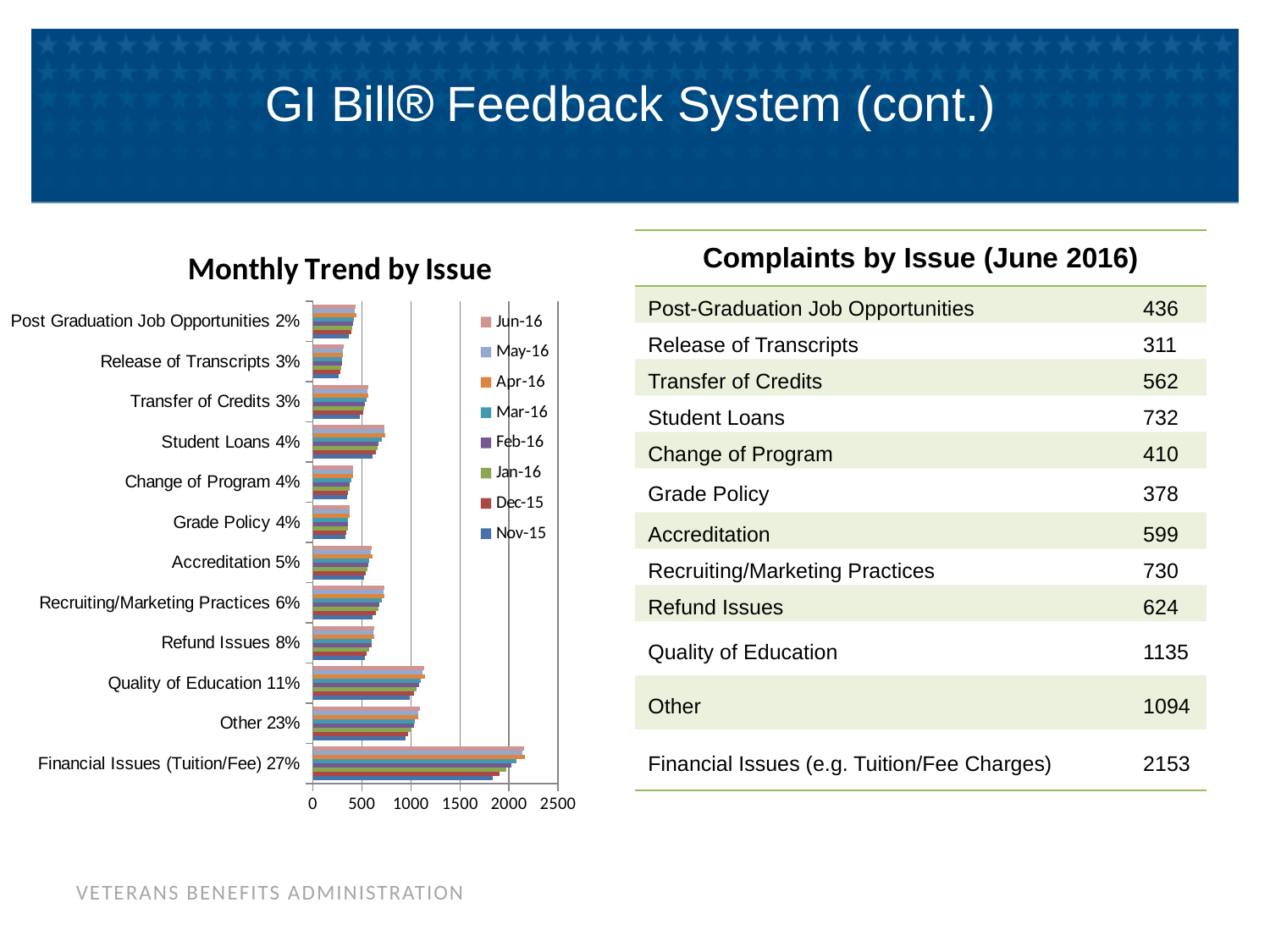
How many series does the legend of the "Monthly Trend by Issue" chart list? 8 What is the first entry listed in the legend of the "Monthly Trend by Issue" chart? Jun-16 In the "Monthly Trend by Issue" chart, is the Jun-16 value for Accreditation greater or less than 1000? less In the "Monthly Trend by Issue" chart, is the Jun-16 value for Financial Issues (Tuition/Fee) greater or less than 2000? greater In the "Monthly Trend by Issue" chart, which has the larger Jun-16 value: Quality of Education or Refund Issues? Quality of Education Which issue category has the longest bars in the "Monthly Trend by Issue" chart? Financial Issues (Tuition/Fee) 27% In the "Monthly Trend by Issue" chart, is the Jun-16 value for Quality of Education greater or less than 1000? greater In the "Monthly Trend by Issue" chart, which has the larger Jun-16 value: Financial Issues (Tuition/Fee) or Other? Financial Issues (Tuition/Fee) How many issue categories are shown on the y axis of the "Monthly Trend by Issue" chart? 12 What kind of chart is "Monthly Trend by Issue"? bar chart Which issue category has the shortest bars in the "Monthly Trend by Issue" chart? Release of Transcripts 3%